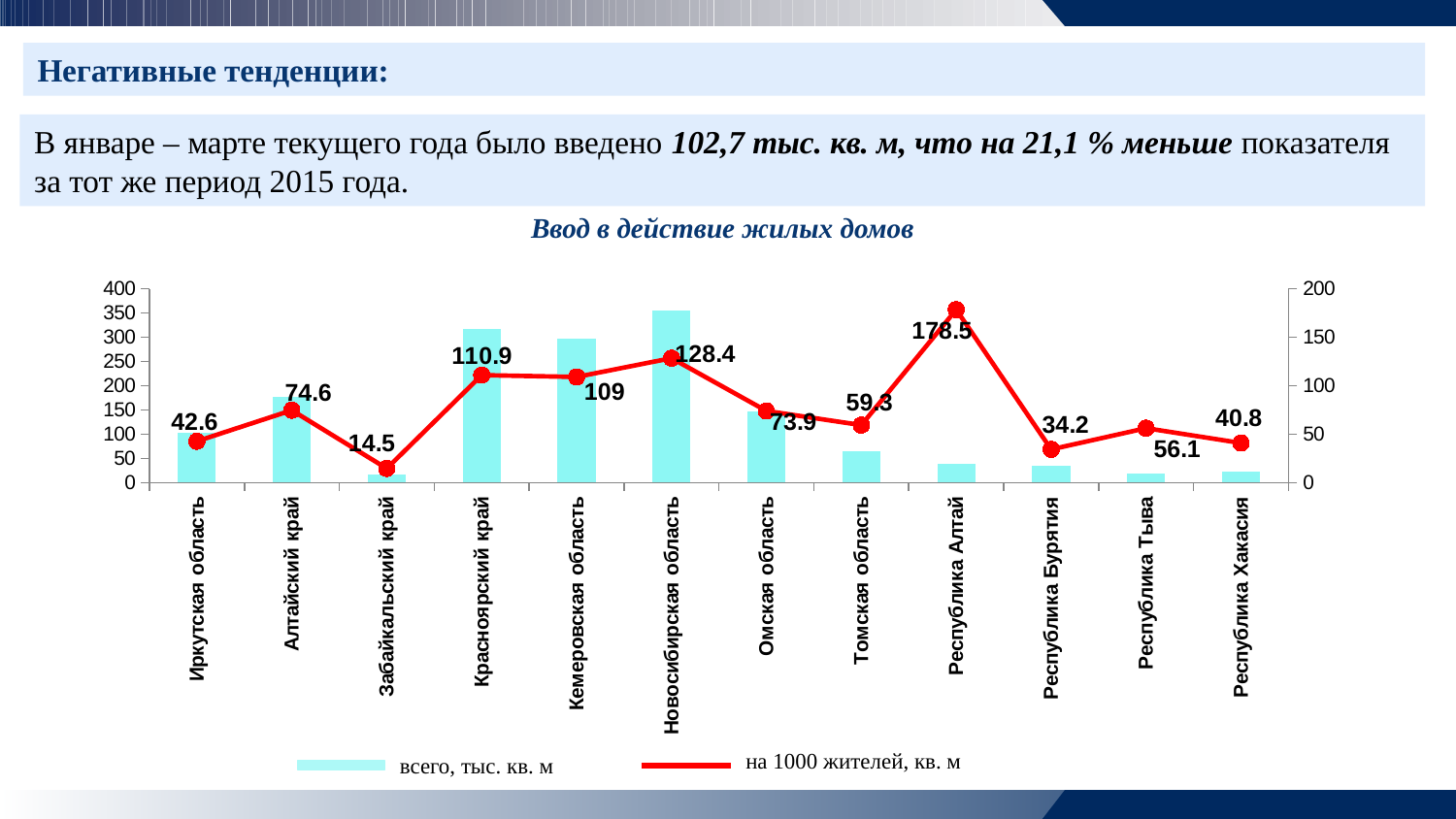
What is the difference between the 'на 1000 жителей, кв. м' values for Республика Алтай and Забайкальский край? 164 Is the 'всего, тыс. кв. м' bar for Новосибирская область greater or less than 300? greater Is the 'всего, тыс. кв. м' bar for Забайкальский край greater or less than 50? less How many series does the chart legend list? 2 What is the value of the 'на 1000 жителей, кв. м' line for Кемеровская область? 109 Which has a larger 'на 1000 жителей, кв. м' value: Красноярский край or Омская область? Красноярский край Which region has the lowest value on the 'на 1000 жителей, кв. м' line? Забайкальский край Which region has the highest value on the 'на 1000 жителей, кв. м' line? Республика Алтай How many regions are shown on the x axis of the chart? 12 What is the value of the 'на 1000 жителей, кв. м' line for Республика Алтай? 178.5 What is the title of the chart? Ввод в действие жилых домов What is the value of the 'на 1000 жителей, кв. м' line for Республика Хакасия? 40.8